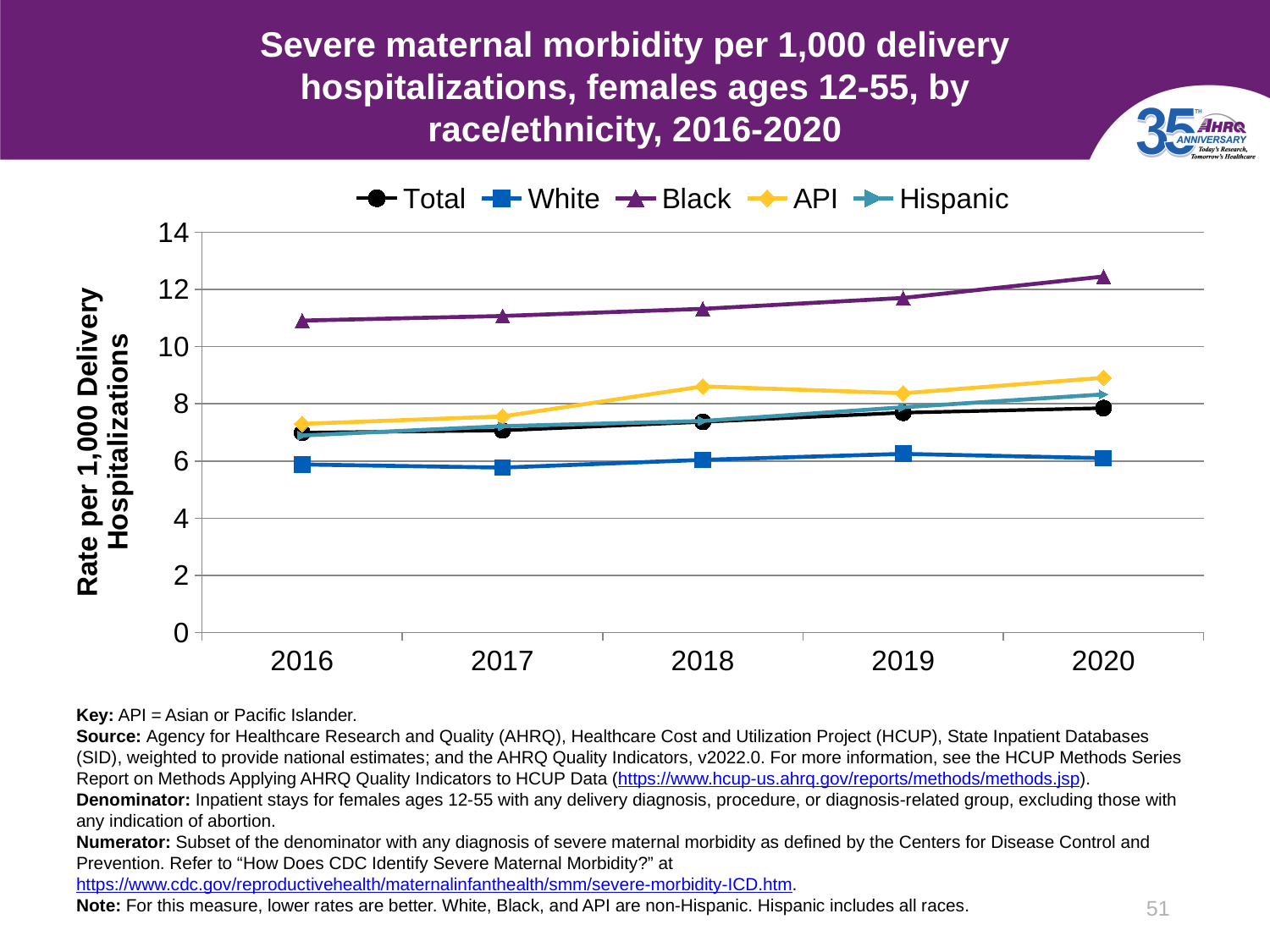
Which is larger, the value for Black in 2016 or the value for API in 2020? Black in 2016 Does the rate for Black females rise or fall from 2016 to 2020? rise Which race/ethnicity group has the highest rate in 2020? Black Which race/ethnicity group has the lowest rate in 2020? White What kind of chart is shown on the slide? line chart How many years are plotted along the x axis? 5 How many series does the legend list? 5 What is the label on the y axis? Rate per 1,000 Delivery Hospitalizations Is the value for Black in 2020 greater or less than 12? greater Is the value for Black in 2016 greater or less than 10? greater Which is larger in 2018, the value for API or the value for White? API Is the value for Total in 2016 greater or less than 8? less